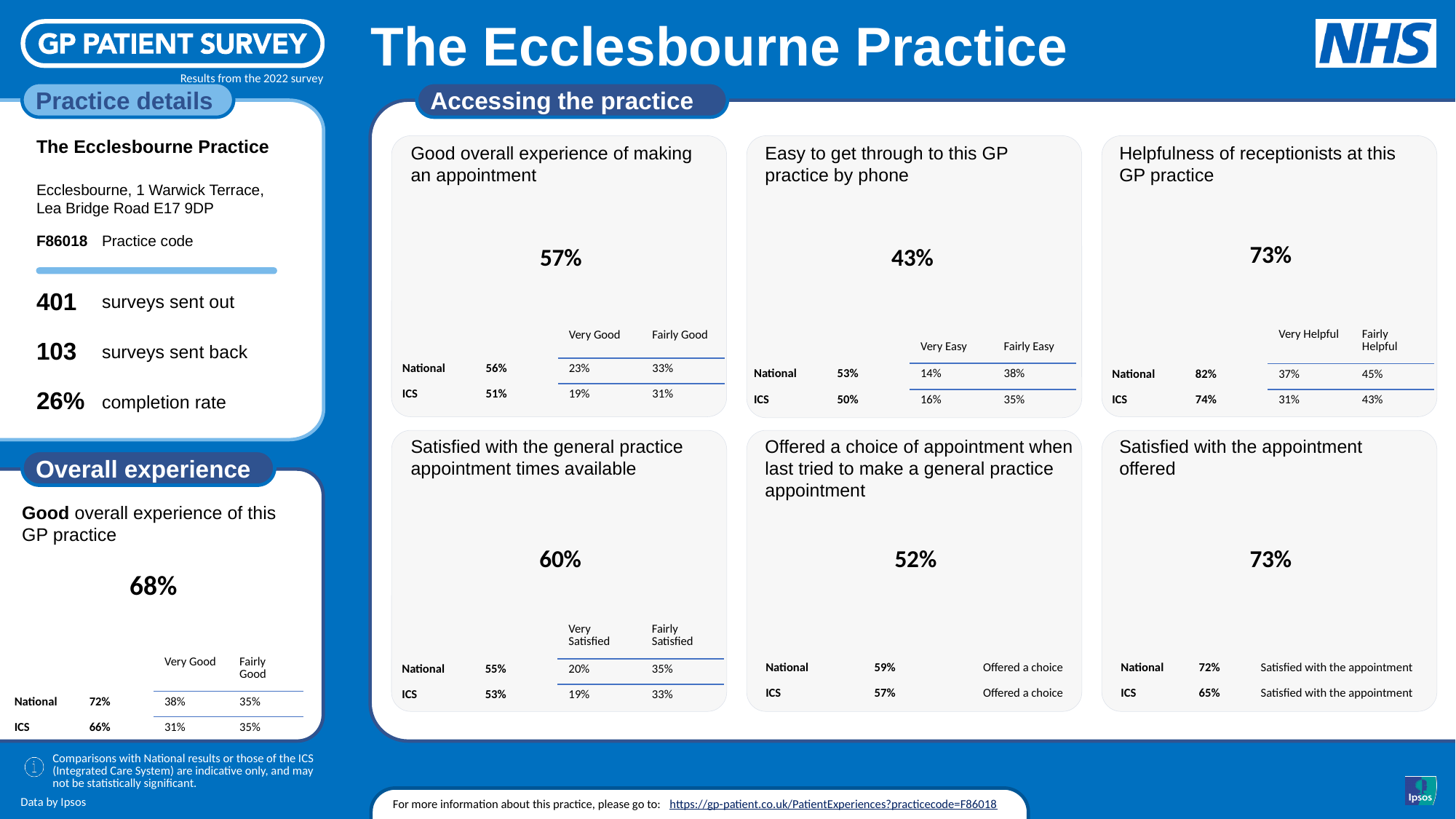
In the 'Satisfied with the appointment offered' panel, which is larger: the practice's 73% or the National 72%? The practice's 73% Across the six 'Accessing the practice' panels, what is the highest practice headline percentage shown? 73% In the 'Overall experience' section, what is the ICS 'Very Good' value? 31% In the 'Helpfulness of receptionists at this GP practice' panel, what is the ICS 'Very Helpful' value? 31% How many panels are shown in the 'Accessing the practice' section? 6 In the 'Helpfulness of receptionists at this GP practice' panel, what is the difference between the National value and the practice's headline value? 9% In the 'Good overall experience of making an appointment' panel, what is the practice's headline percentage? 57% In the 'Easy to get through to this GP practice by phone' panel, what is the National value? 53% In the 'Offered a choice of appointment when last tried to make a general practice appointment' panel, what is the difference between the National value and the ICS value? 2% Across the six 'Accessing the practice' panels, which measure has the lowest practice headline percentage? Easy to get through to this GP practice by phone In the 'Overall experience' section, what is the practice's 'Good overall experience of this GP practice' percentage? 68% In the 'Satisfied with the general practice appointment times available' panel, what is the National 'Fairly Satisfied' value? 35%